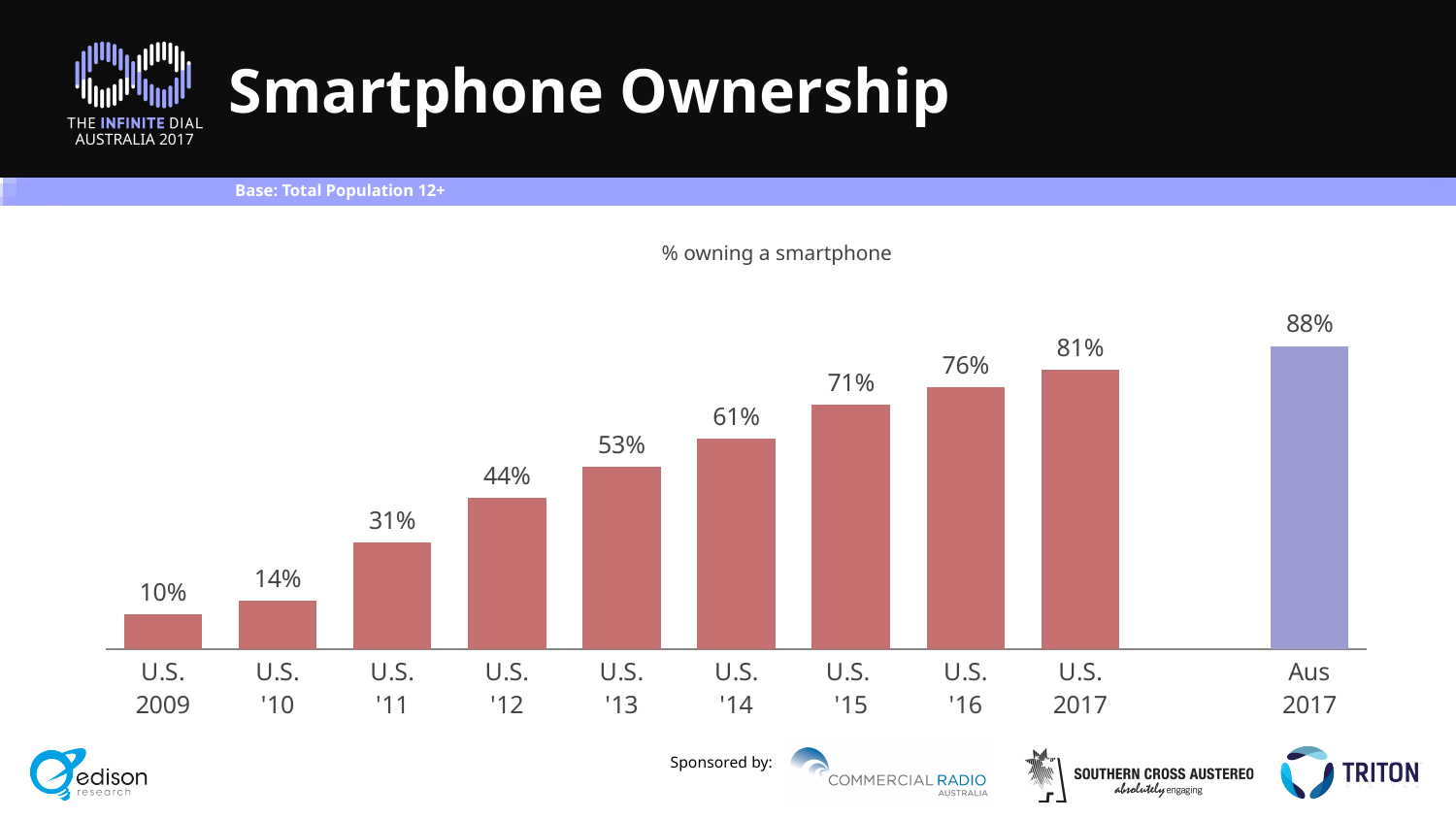
Which is larger, the value for U.S. '12 or the value for U.S. '11? U.S. '12 What is the value shown for U.S. 2017? 81% What is the difference between the U.S. '16 value and the U.S. '15 value? 5% What is the difference between the Aus 2017 value and the U.S. 2017 value? 7% What percentage of the U.S. population owned a smartphone in 2009? 10% How many bars are plotted on the chart? 10 What is the value shown for Aus 2017? 88% Which category has the lowest value on the chart? U.S. 2009 What is the value shown for U.S. '13? 53% Do the U.S. values rise or fall from 2009 to 2017? Rise What kind of chart is shown on the slide? Bar chart Which category has the highest value on the chart? Aus 2017